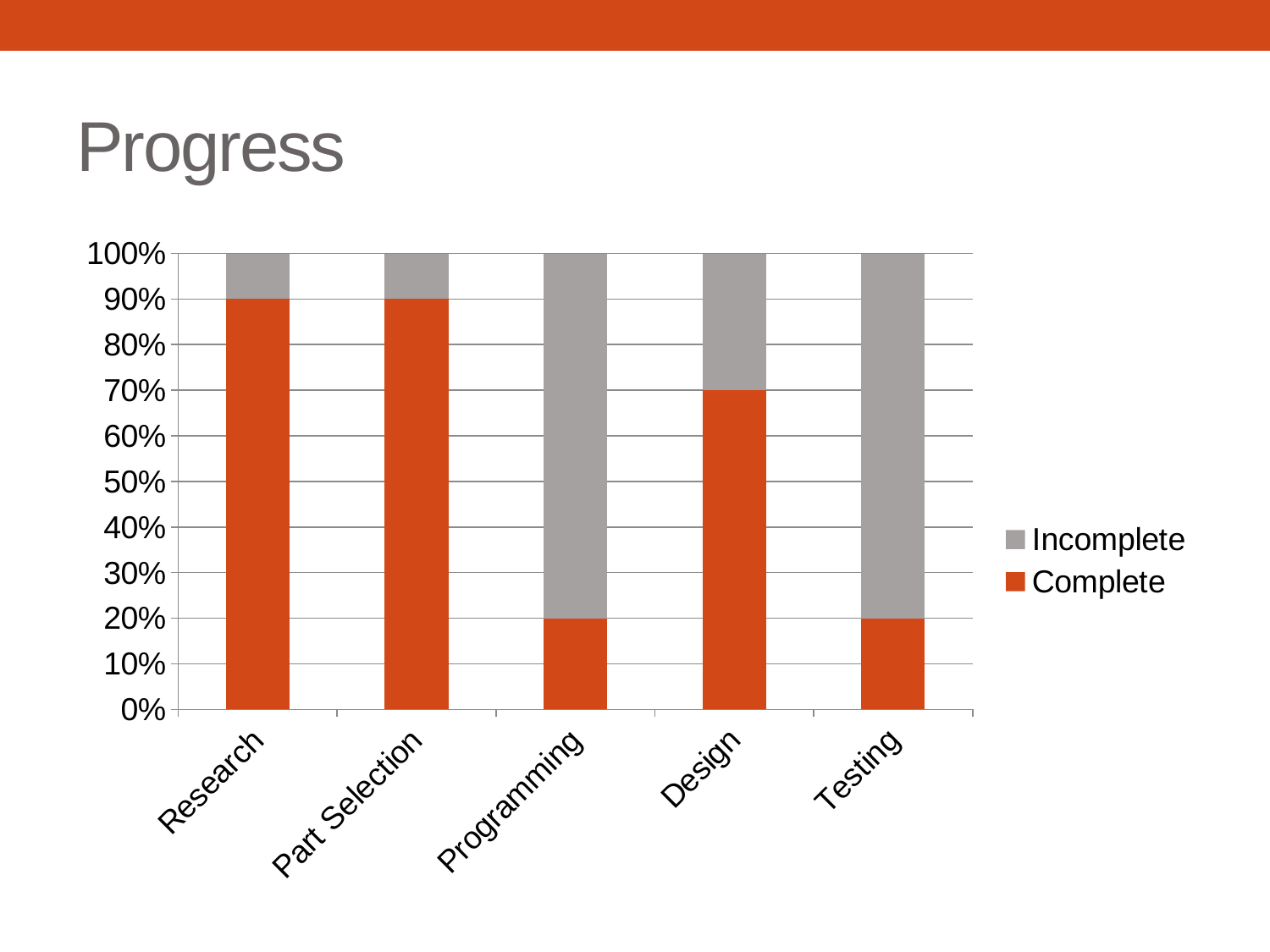
What kind of chart is shown on the slide? Stacked bar chart What is the Complete value for Research? 90% What is the Complete value for Design? 70% Which has a larger Complete value, Design or Testing? Design What is the Incomplete value for Testing? 80% How many categories are shown on the x axis? 5 What is the difference between the Complete values for Design and Programming? 50% Which has a larger Complete value, Research or Design? Research What is the Complete value for Programming? 20% What is the total of the stacked bar for Part Selection? 100% What is the title of the slide containing the chart? Progress How many series does the legend list? 2